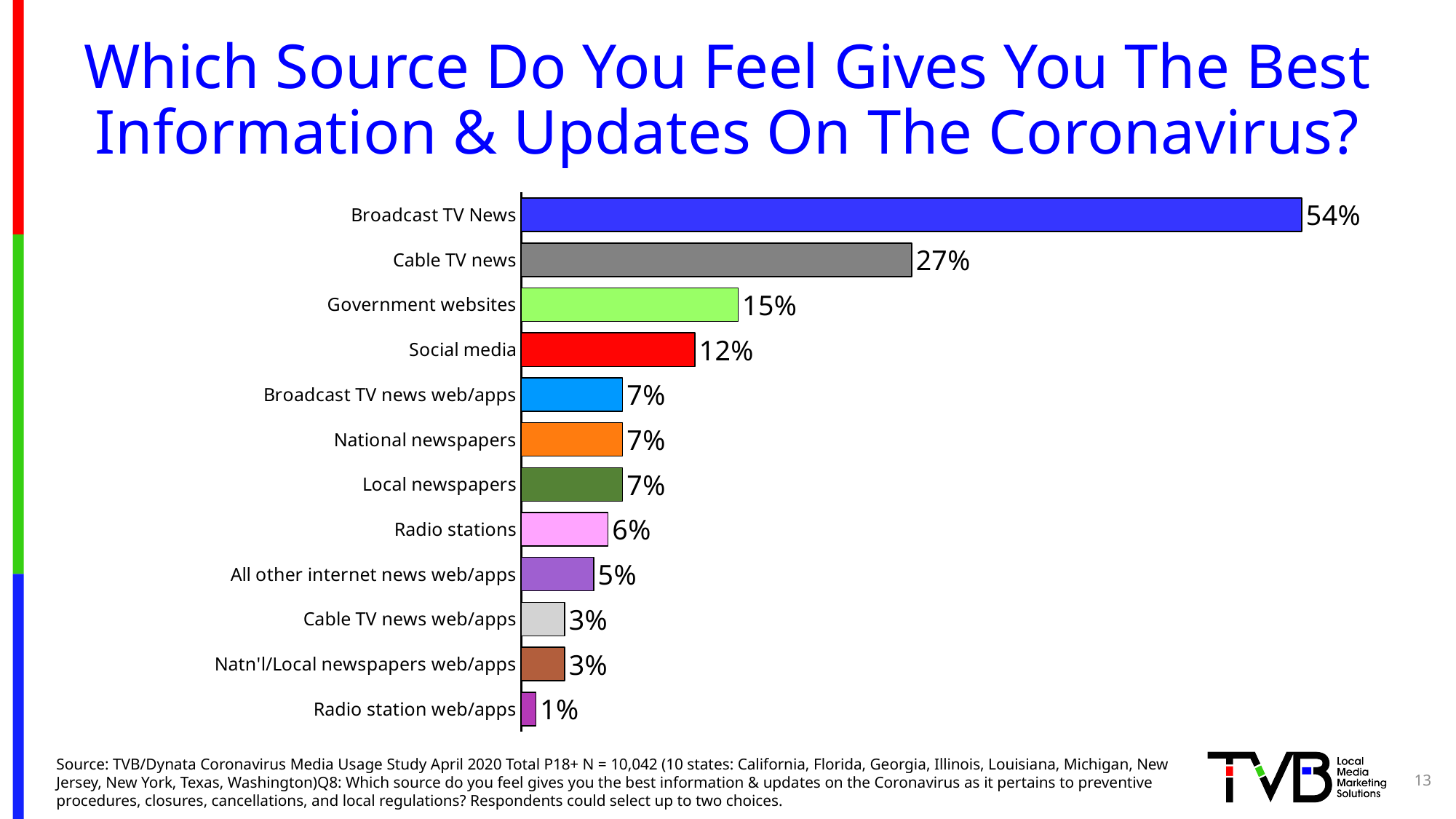
What is the value shown for Radio station web/apps? 1% Which source has the highest percentage on the chart? Broadcast TV News What type of chart is shown on the slide? Bar chart What colour is the bar for Social media? Red How many sources (categories) are shown on the chart? 12 Which source has the lowest percentage on the chart? Radio station web/apps What is the value shown for Government websites? 15% Which has a larger value, Cable TV news or Social media? Cable TV news Which has a larger value, Radio stations or All other internet news web/apps? Radio stations What is the difference in percentage points between Broadcast TV News and Cable TV news? 27 What percentage of respondents chose Broadcast TV News as the best source of information on the Coronavirus? 54% What is the difference in percentage points between Government websites and Social media? 3